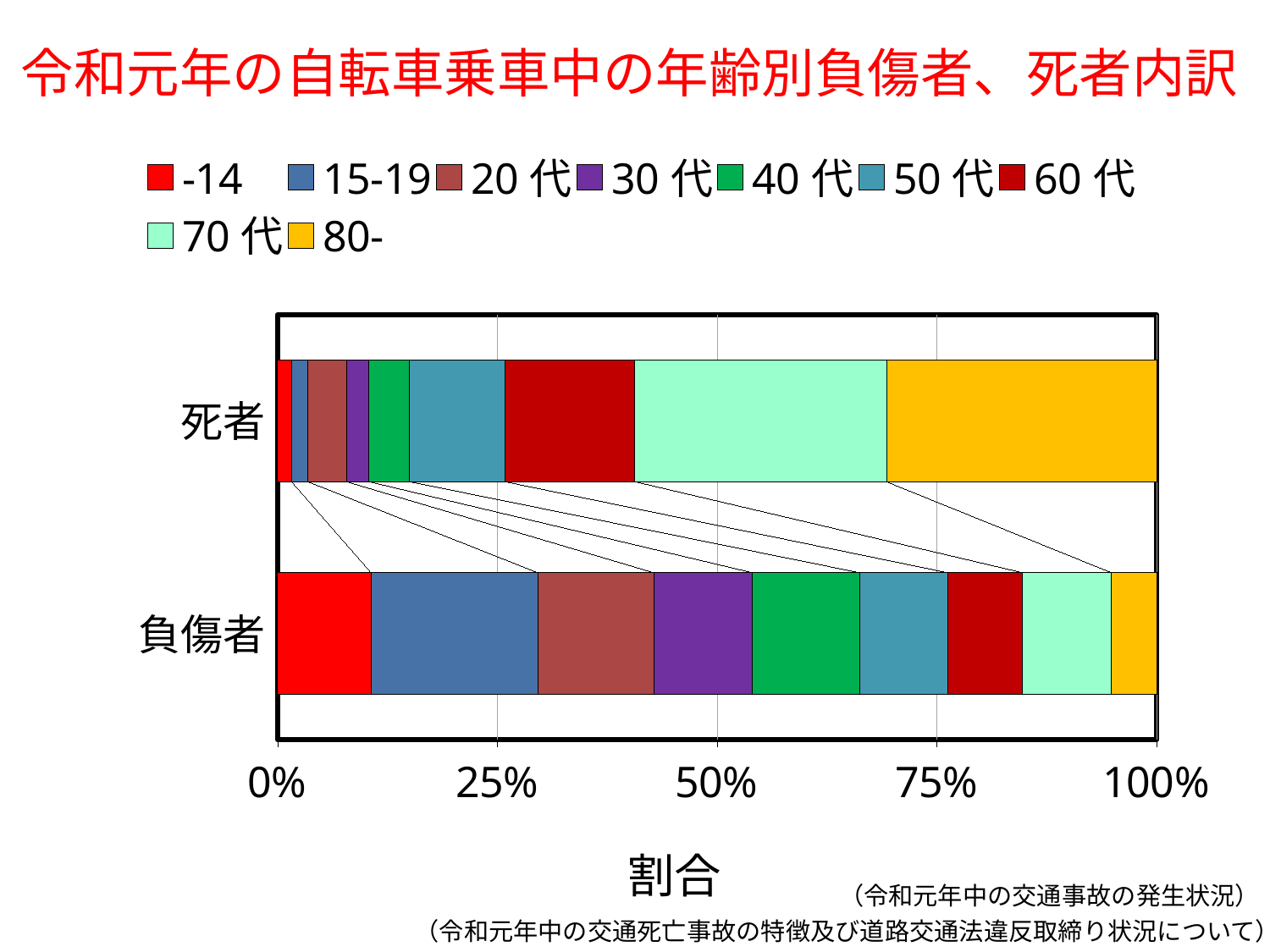
How many series does the legend list? 9 Is the share of the 80- group in the 死者 bar greater or less than 25%? greater How many categories (bars) does the chart show? 2 Which bar has the larger share for the -14 age group, 死者 or 負傷者? 負傷者 What is the label on the horizontal axis? 割合 What kind of chart is shown on the slide? stacked bar chart Which age group has the largest share in the 負傷者 bar? 15-19 Is the share of the -14 group in the 負傷者 bar greater or less than 25%? less Which age group has the smallest share in the 負傷者 bar? 80- What is the title of the chart? 令和元年の自転車乗車中の年齢別負傷者、死者内訳 Which bar has the larger share for the 80- age group, 死者 or 負傷者? 死者